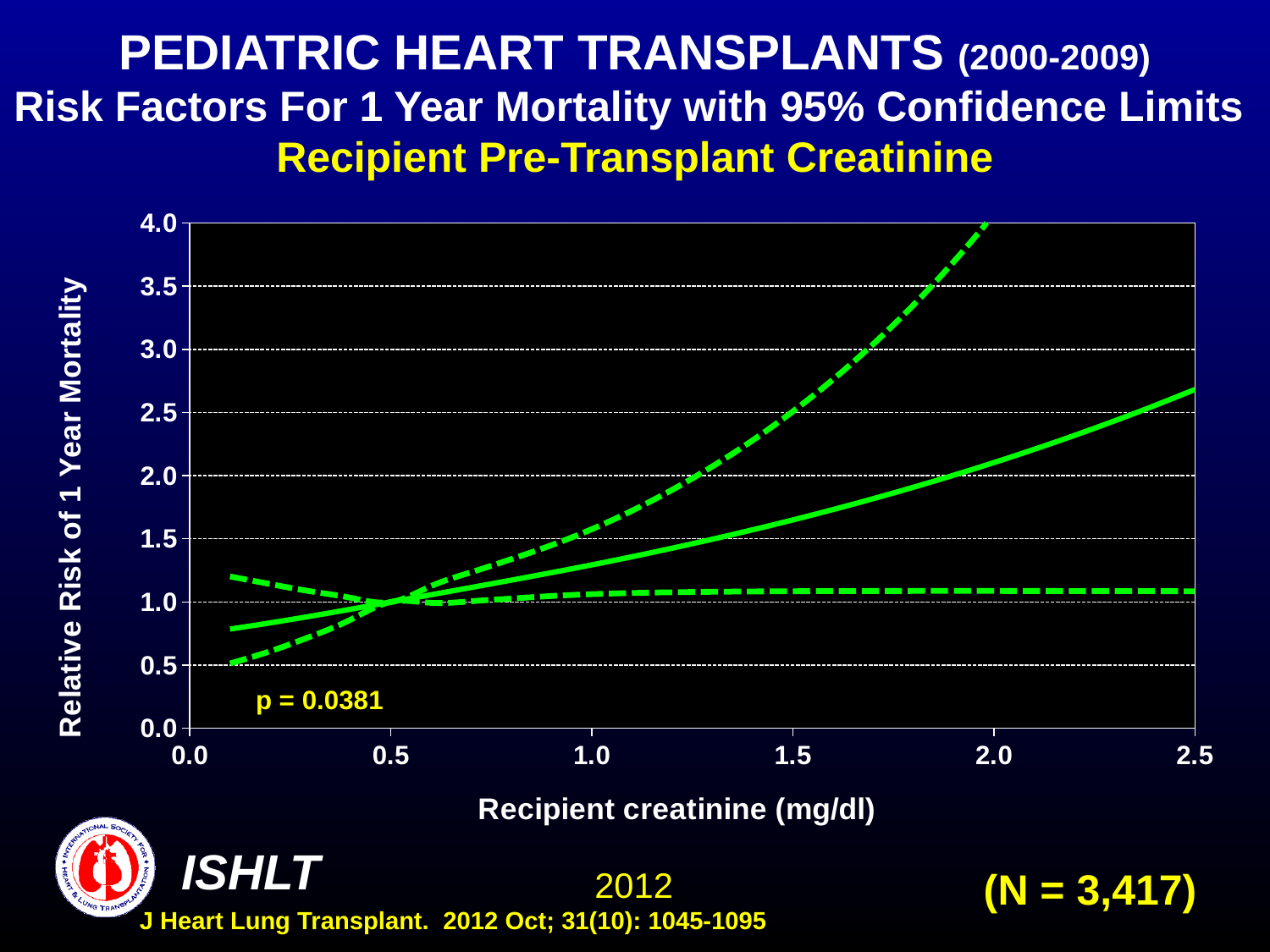
Is the value of the upper dashed confidence limit at a recipient creatinine of 1.5 mg/dl greater or less than 2.0? greater Does the solid line for relative risk of 1 year mortality rise or fall as recipient creatinine increases? rise What is the p-value printed on the chart? p = 0.0381 Is the value of the solid relative risk line at the left end of the chart (near a creatinine of 0.1 mg/dl) greater or less than 1.0? less Is the value of the solid relative risk line at a recipient creatinine of 2.5 mg/dl greater or less than 2.0? greater What is the label of the x axis? Recipient creatinine (mg/dl) How many lines are plotted on the chart? 3 What kind of chart is shown on the slide? line chart What is the maximum value shown on the y axis? 4.0